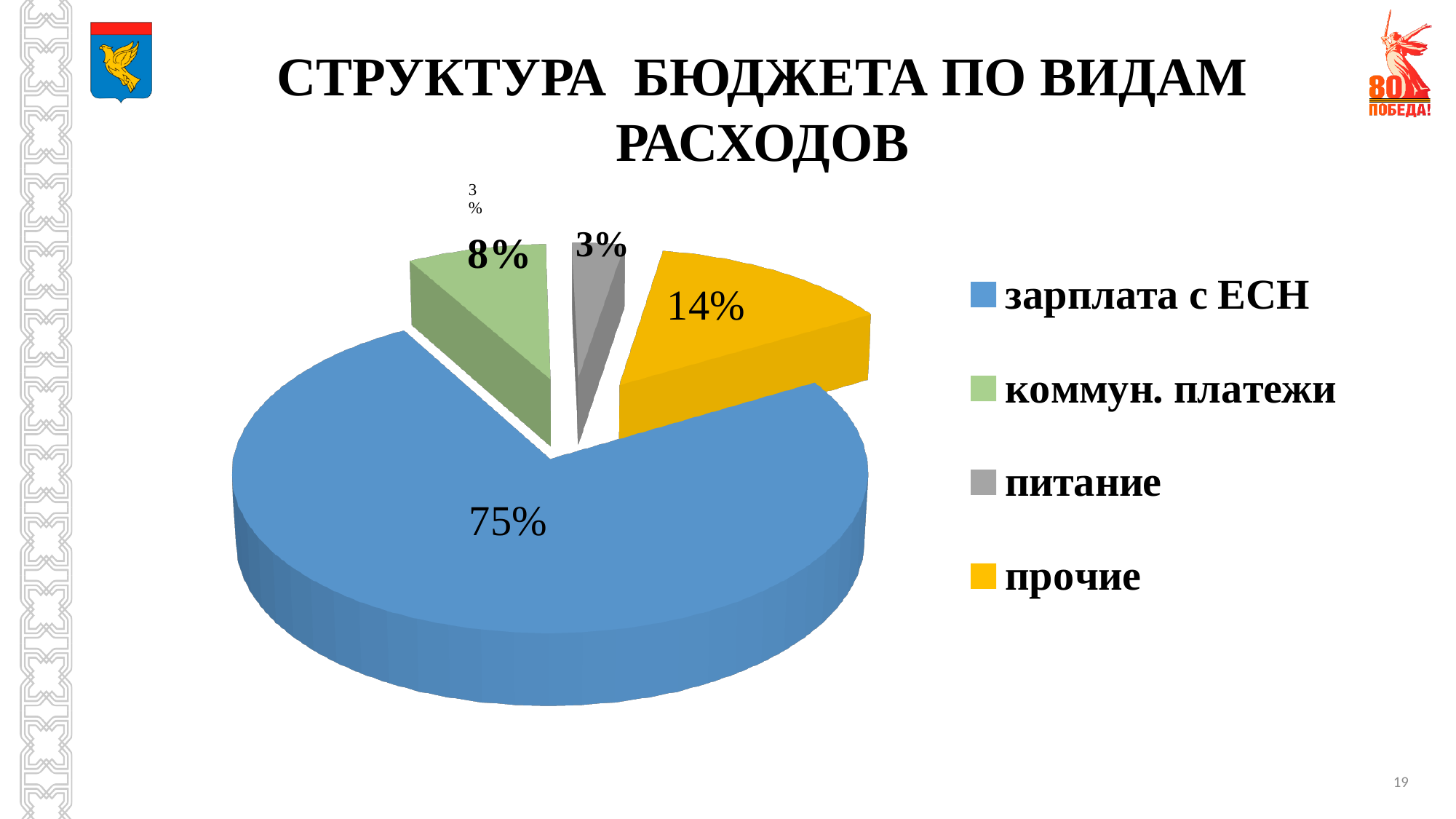
What share of the budget does "зарплата с ЕСН" take in the pie chart? 75% Which is larger, the share for "коммун. платежи" or the share for "прочие"? прочие What is the title of the slide containing the chart? СТРУКТУРА БЮДЖЕТА ПО ВИДАМ РАСХОДОВ What percentage is shown for "коммун. платежи"? 8% Which colour represents "прочие" in the legend? yellow What percentage is shown for "прочие"? 14% What percentage is shown for "питание"? 3% Which category has the largest slice of the pie? зарплата с ЕСН What type of chart is shown on the slide? pie chart What is the difference in percentage points between "зарплата с ЕСН" and "прочие"? 61 Which category has the smallest slice of the pie? питание How many categories does the pie chart show? 4